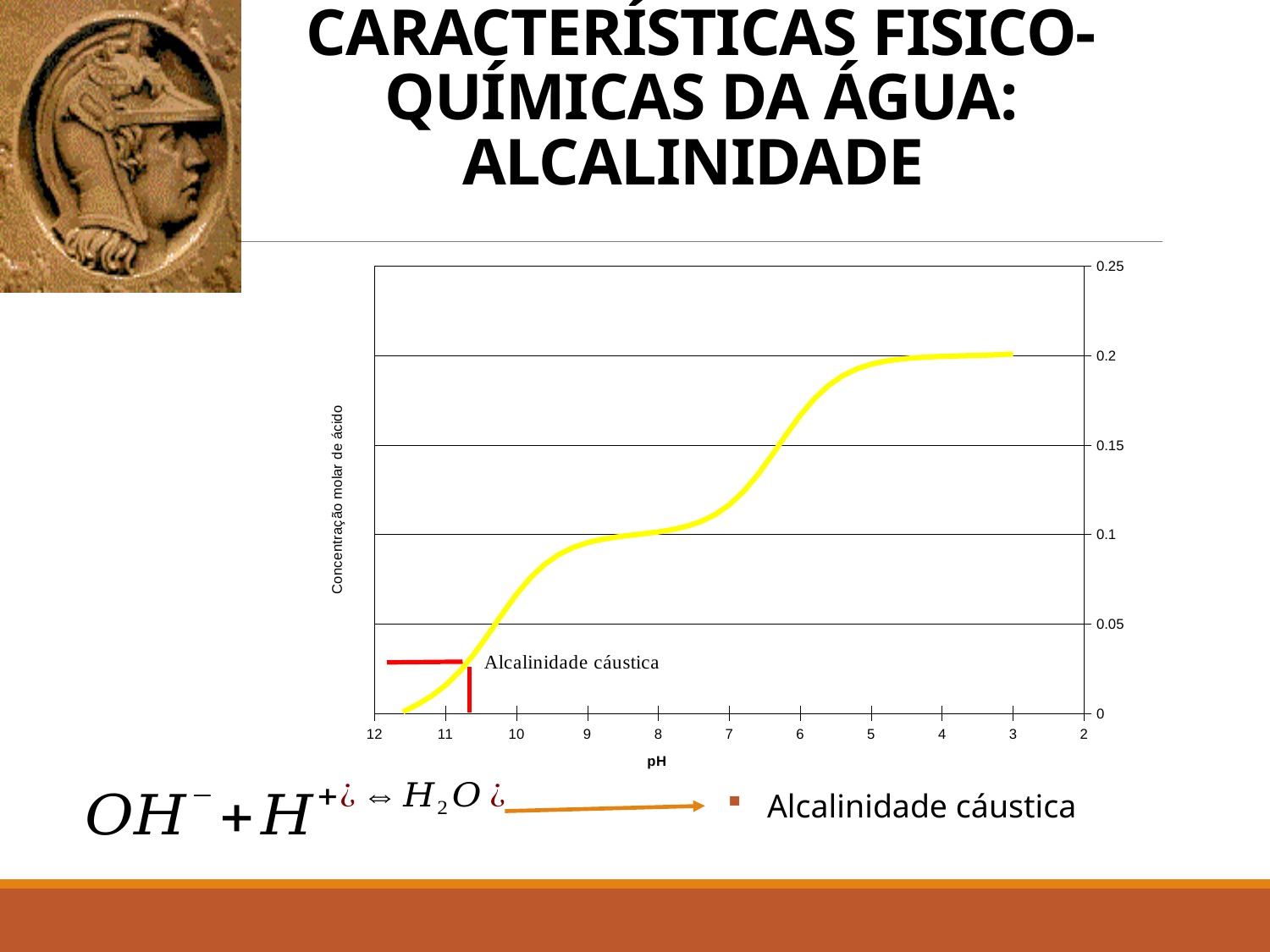
What is the label of the y axis of the chart? Concentração molar de ácido Is the value of the curve at pH 5 greater or less than 0.15? greater How many pH tick labels are shown along the x axis? 11 Is the value of the curve at pH 3 greater or less than 0.15? greater Which is larger, the value of the curve at pH 4 or at pH 9? pH 4 Is the value of the curve at pH 10 greater or less than 0.1? less What is the label of the x axis of the chart? pH What kind of chart is shown on the slide? line chart What is the highest value shown on the y axis of the chart? 0.25 Does the plotted curve rise or fall from left to right across the chart? rise